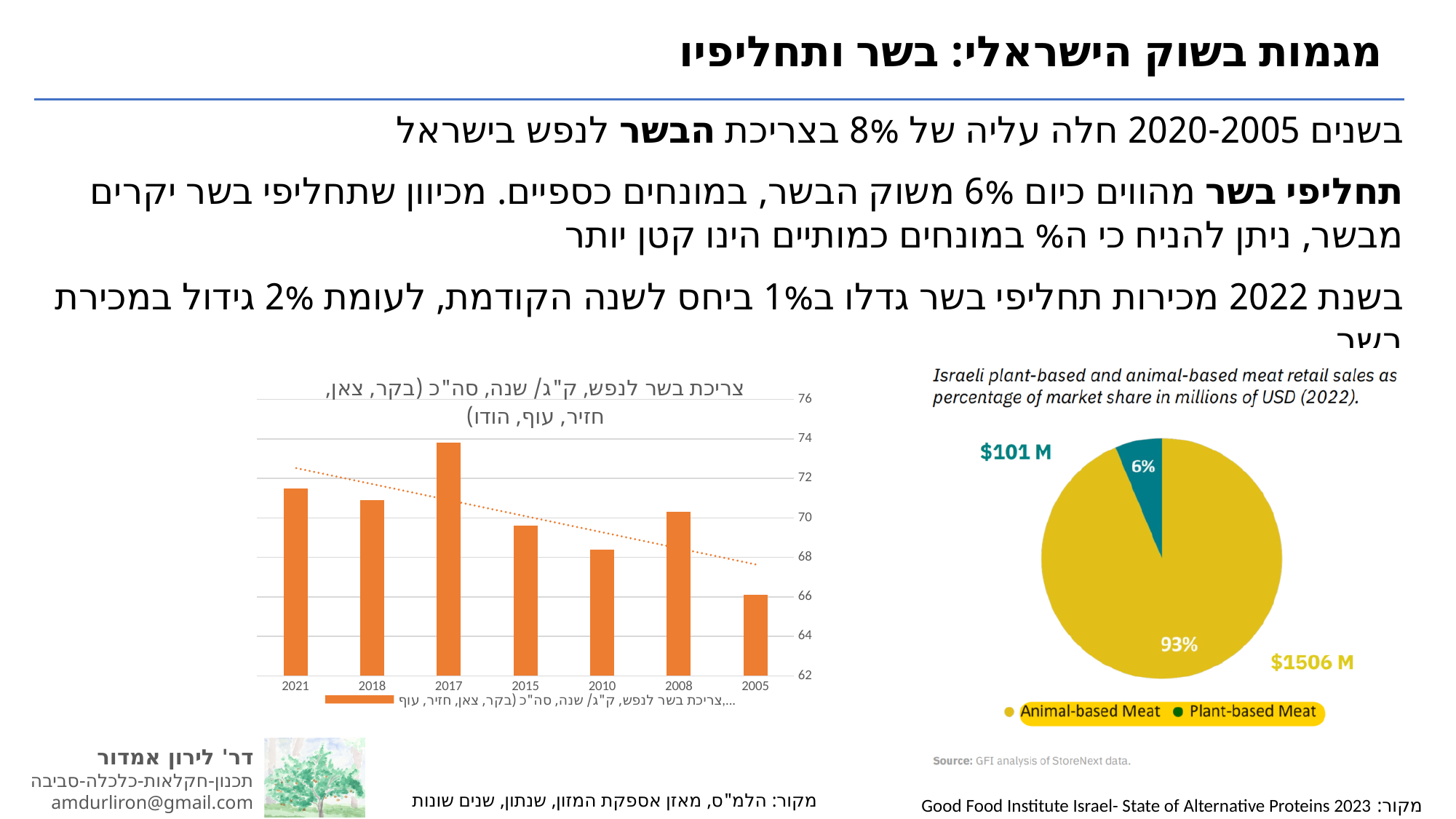
In the right pie chart, what is the retail sales value shown for Plant-based Meat? $101 M What kind of chart is the left chart showing meat consumption per capita by year? bar chart In the left bar chart, which year has the lowest bar? 2005 How many years are shown on the x axis of the left bar chart? 7 In the right pie chart, what percentage of market share does Animal-based Meat hold? 93% In the left bar chart, is the value for 2017 greater or less than 72? greater In the left bar chart, is the value for 2005 greater or less than 68? less How many entries does the legend of the right pie chart list? 2 In the left bar chart, which year has the highest bar? 2017 In the left bar chart, is the value for 2010 greater or less than 70? less In the right pie chart, what is the retail sales value shown for Animal-based Meat? $1506 M In the left bar chart, which bar is taller, 2021 or 2015? 2021